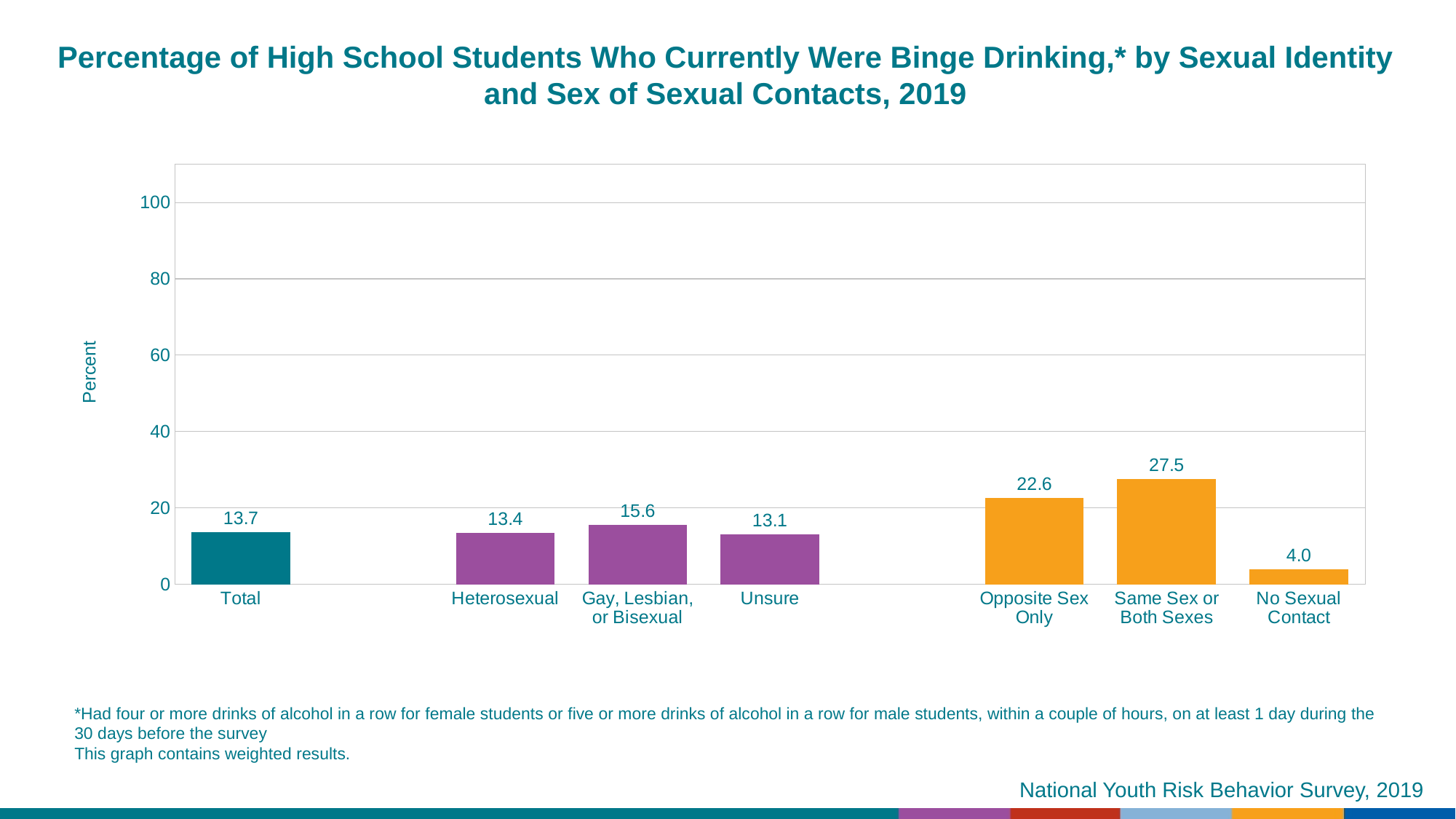
What is the difference between the values for Same Sex or Both Sexes and Opposite Sex Only? 4.9 Which is larger, the value for Heterosexual or the value for Unsure? Heterosexual Which category has the lowest value? No Sexual Contact What kind of chart is shown on the slide? Bar chart Is the value for Opposite Sex Only greater or less than 20? greater Which category has the highest value? Same Sex or Both Sexes What is the label of the y axis? Percent What is the value for No Sexual Contact? 4.0 What is the value for Same Sex or Both Sexes? 27.5 What is the value for Gay, Lesbian, or Bisexual? 15.6 What is the value for Total? 13.7 How many bars are shown in the chart? 7